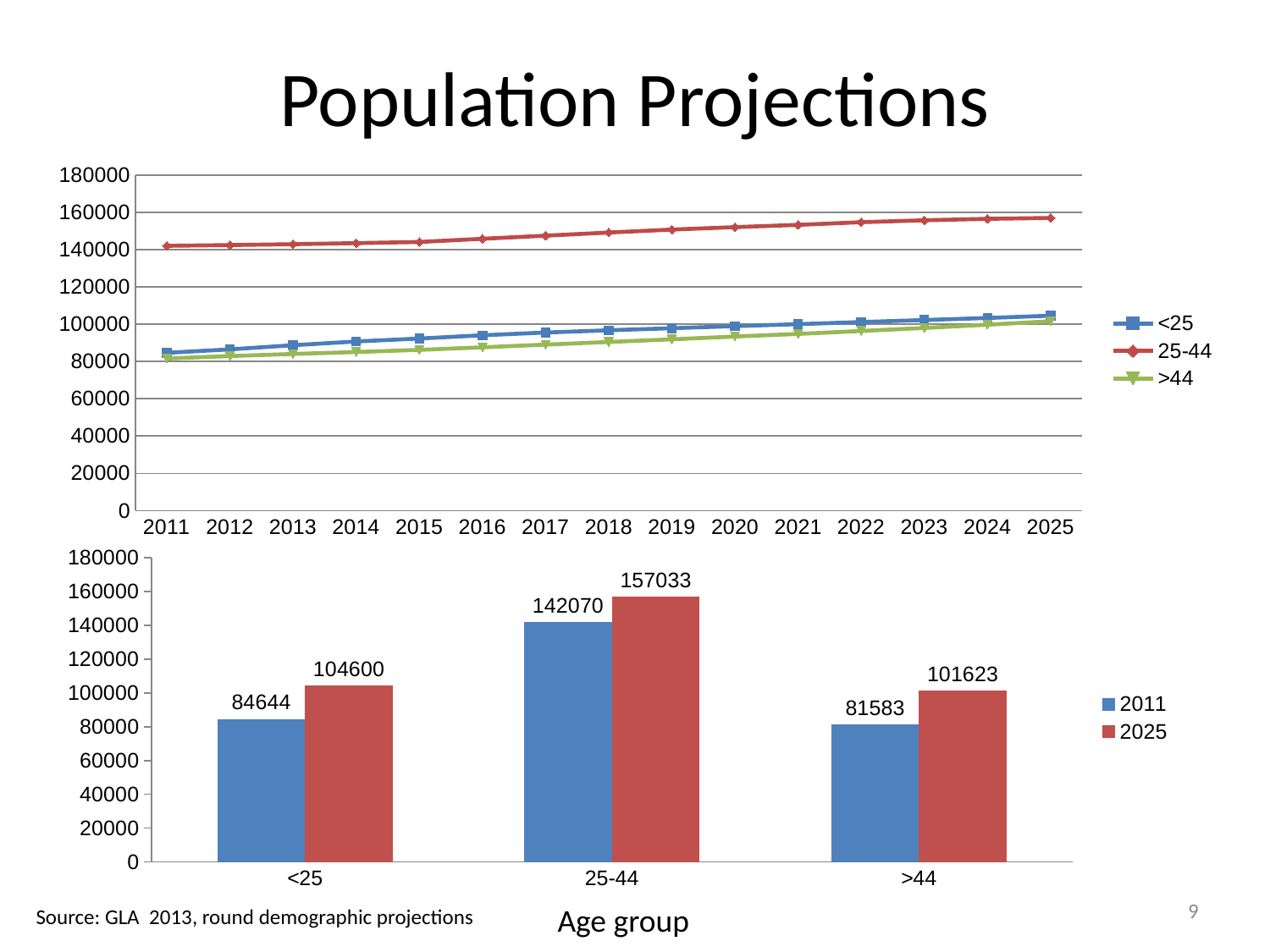
In the bottom bar chart, what is the value for the >44 age group in 2025? 101623 In the top line chart, how many series does the legend list? 3 In the bottom bar chart, how many series does the legend list? 2 In the bottom bar chart, what is the value for the 25-44 age group in 2025? 157033 In the bottom bar chart, which age group has the lowest value in 2025? >44 In the top line chart, is the value for the 25-44 series in 2025 greater or less than 140000? greater What kind of chart is the top chart on the slide? Line chart In the bottom bar chart, what is the value for the <25 age group in 2011? 84644 In the bottom bar chart, what is the difference between the 2025 and 2011 values for the 25-44 age group? 14963 In the top line chart, does the <25 series rise or fall from 2011 to 2025? Rise In the bottom bar chart, which age group has the highest value in 2011? 25-44 In the bottom bar chart, which is larger: the 2011 value for <25 or the 2011 value for >44? 2011 value for <25